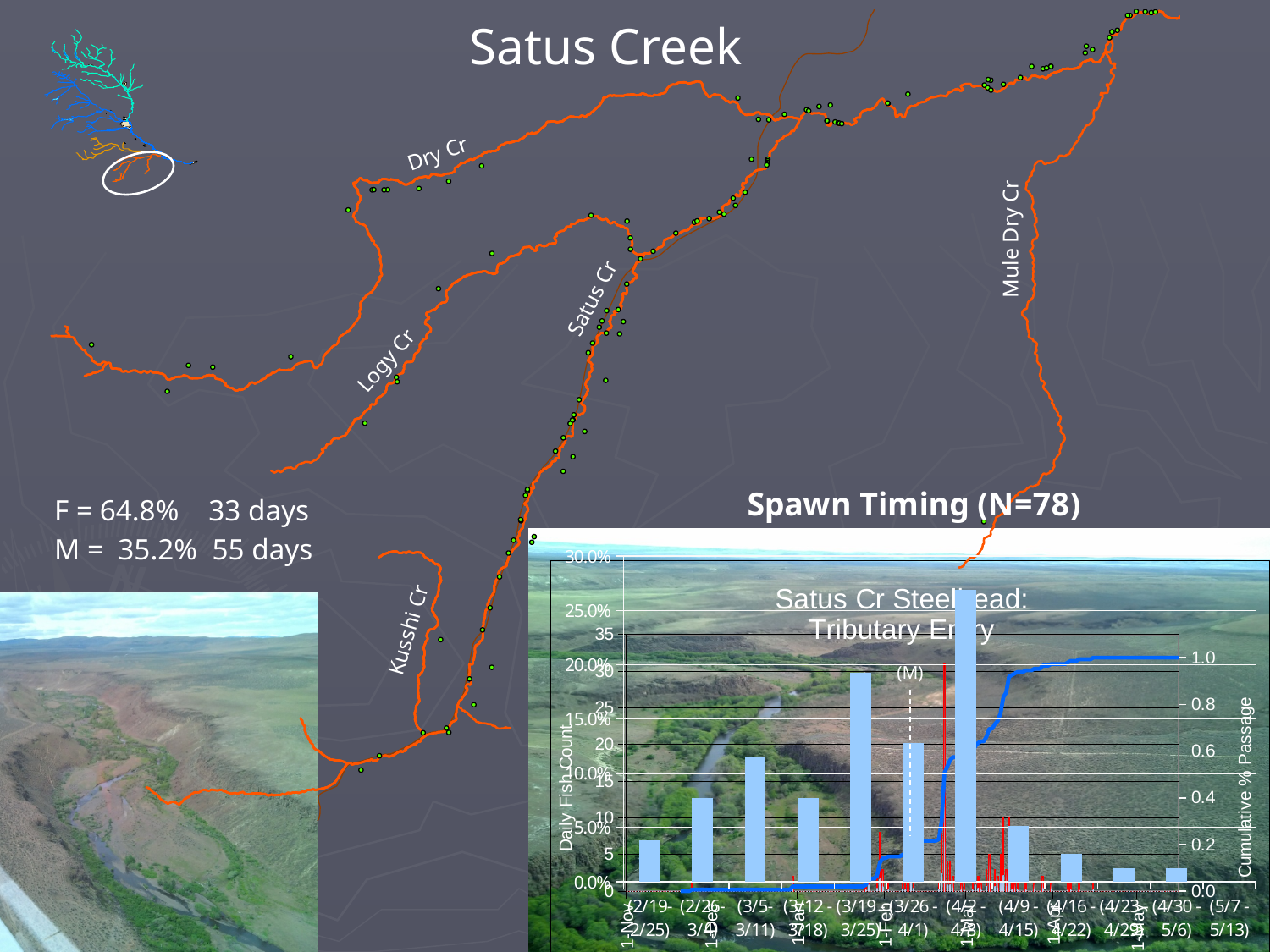
In the Spawn Timing (N=78) chart, which is larger, the value for 3/19 - 3/25 or the value for 3/26 - 4/1? 3/19 - 3/25 In the Spawn Timing (N=78) chart, which is larger, the value for 4/9 - 4/15 or the value for 4/16 - 4/22? 4/9 - 4/15 In the Spawn Timing (N=78) chart, is the value for 3/19 - 3/25 greater or less than 15.0%? greater In the Spawn Timing (N=78) chart, is the value for 4/2 - 4/8 greater or less than 25.0%? greater In the Spawn Timing (N=78) chart, is the value for 2/19 - 2/25 greater or less than 10.0%? less In the Spawn Timing (N=78) chart, how many weekly periods are labelled on the x axis? 12 What is the label of the right-hand vertical axis of the Satus Cr Steelhead: Tributary Entry chart? Cumulative % Passage In the Satus Cr Steelhead: Tributary Entry chart, does the blue cumulative line rise or fall along the x axis? rise In the Spawn Timing (N=78) chart, which weekly period has the highest bar? 4/2 - 4/8 In the Spawn Timing (N=78) chart, what kind of chart is used to show the weekly values? bar chart What is the title of the bar chart in the lower right of the slide? Spawn Timing (N=78)